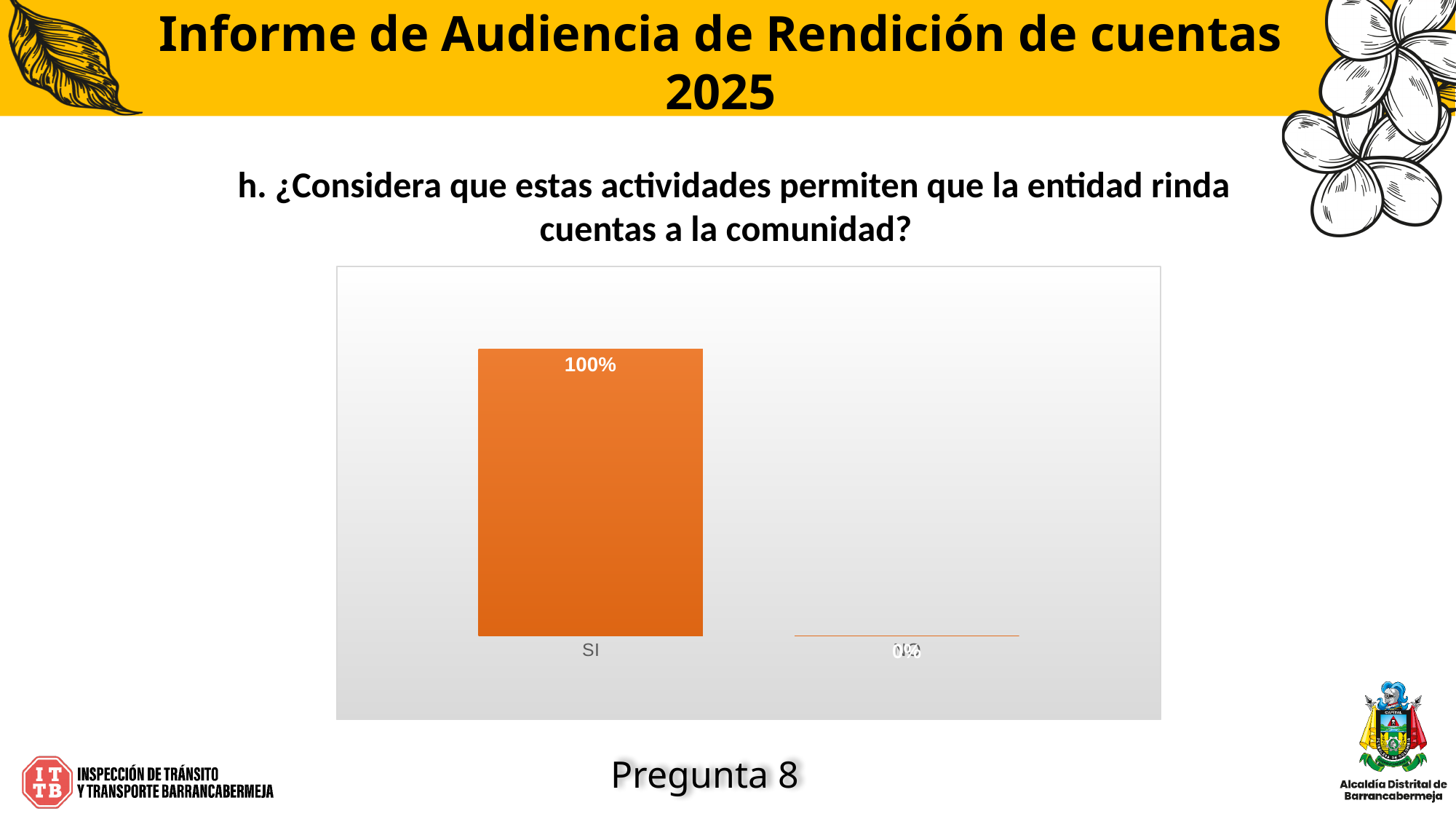
What survey question does the chart on the slide correspond to? h. ¿Considera que estas actividades permiten que la entidad rinda cuentas a la comunidad? How many categories are shown on the x axis of the chart? 2 What colour is the bar for SI? orange Is the value for SI greater or less than 50%? greater What is the value shown for the category SI? 100% What kind of chart is shown on the slide? bar chart Which category has the highest value in the chart? SI